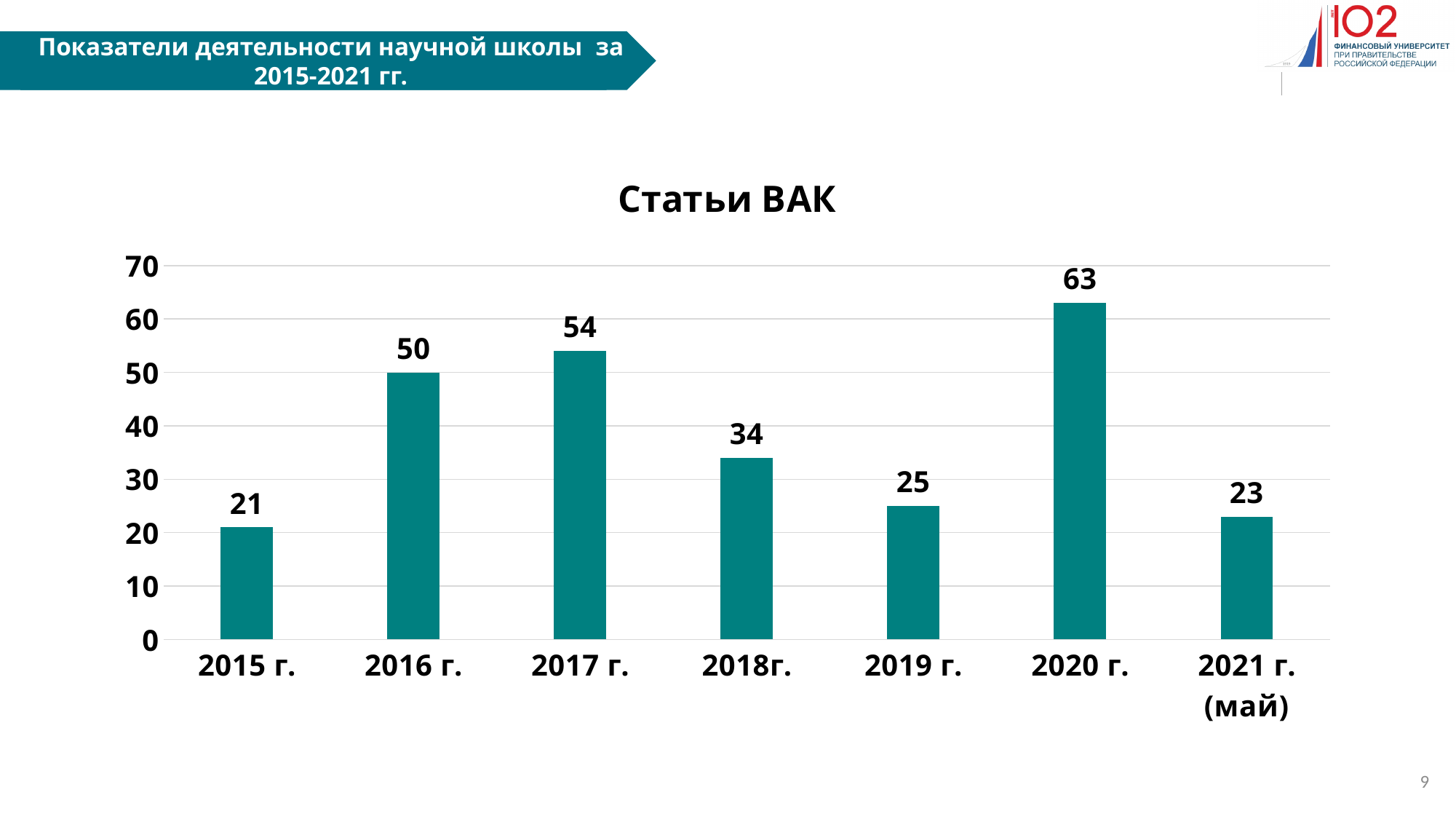
What is the title of the chart? Статьи ВАК What is the difference between the values for 2018г. and 2015 г.? 13 Which is larger, the value for 2016 г. or the value for 2018г.? 2016 г. Which year has the highest value in the chart? 2020 г. What is the value for 2021 г. (май) in the chart? 23 Is the value for 2017 г. greater or less than 50? greater What is the value for 2016 г. in the chart? 50 Which year has the lowest value in the chart? 2015 г. What kind of chart is shown on the slide? bar chart What is the value for 2019 г. in the chart? 25 How many years (categories) are shown in the chart? 7 What is the difference between the values for 2020 г. and 2017 г.? 9